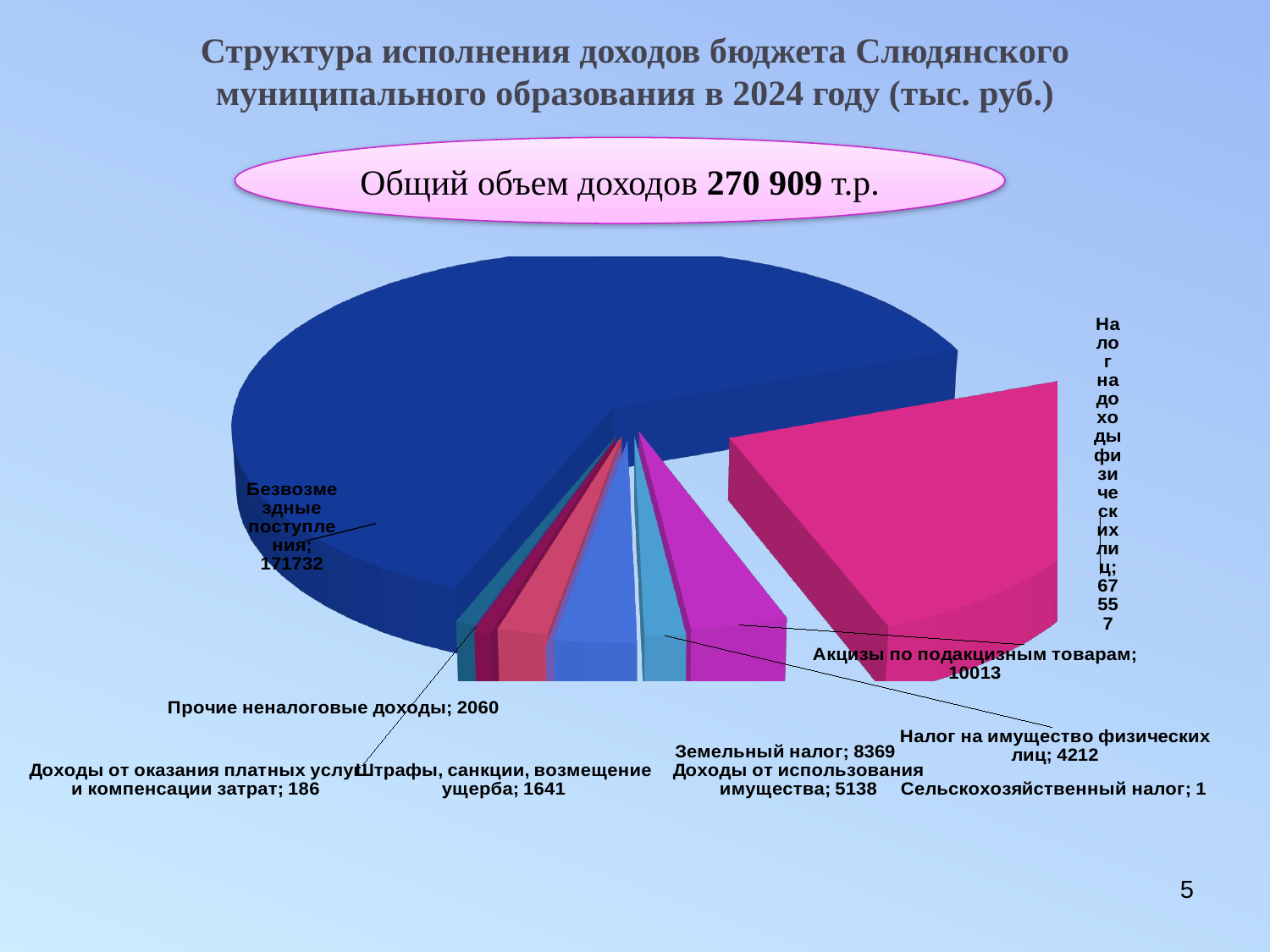
What is the difference between Земельный налог and Доходы от использования имущества? 3231 What total revenue amount is stated in the oval above the chart? 270 909 т.р. What is the value for Налог на доходы физических лиц? 67557 How many categories does the pie chart show? 10 Which category has the largest slice of the pie? Безвозмездные поступления What is the value for Земельный налог? 8369 What kind of chart is shown on the slide? pie chart Which category has the smallest value? Сельскохозяйственный налог What is the value for Безвозмездные поступления? 171732 What is the value for Сельскохозяйственный налог? 1 What is the value for Акцизы по подакцизным товарам? 10013 Which is larger: Налог на имущество физических лиц or Прочие неналоговые доходы? Налог на имущество физических лиц